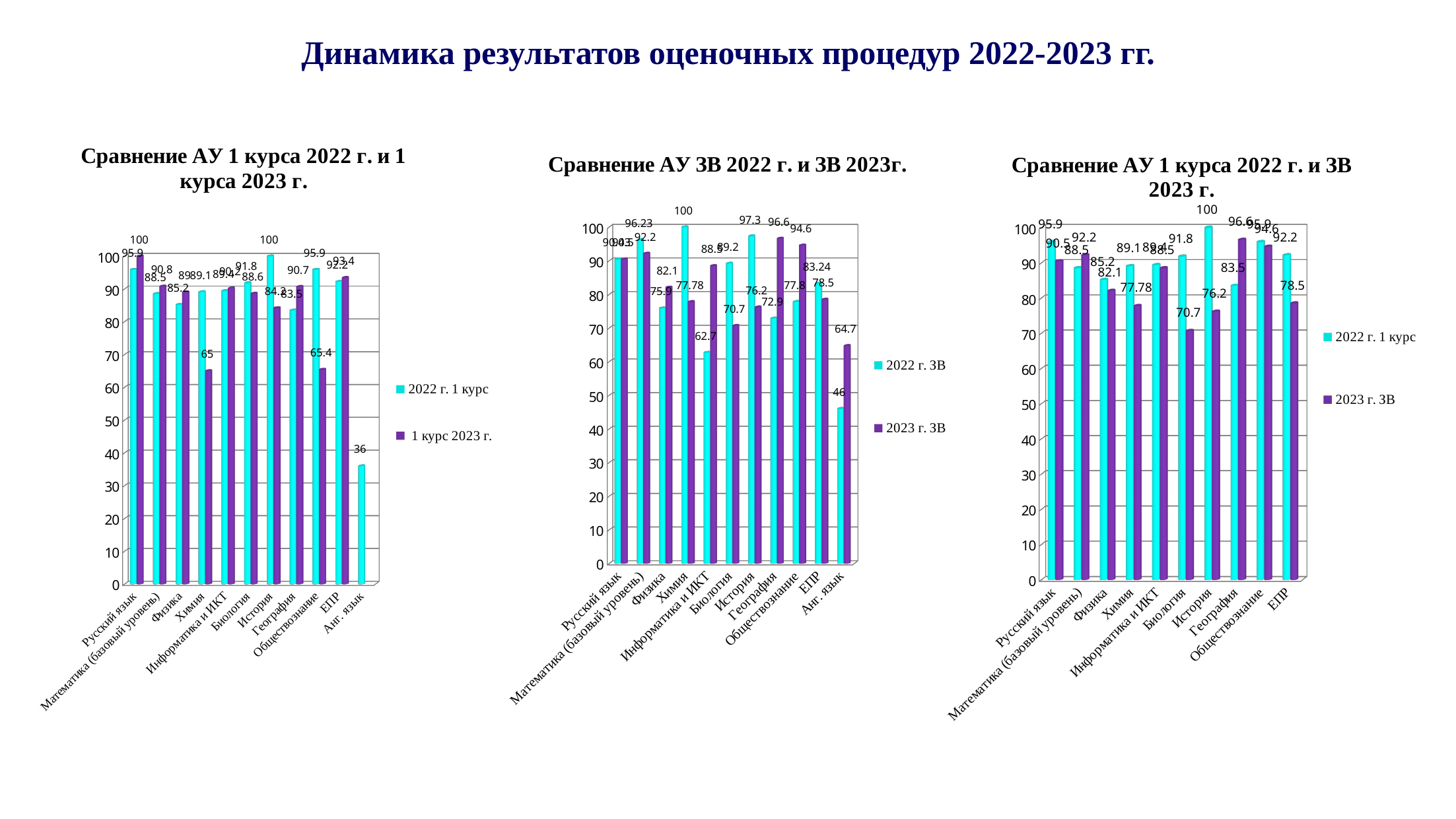
In the right chart 'Сравнение АУ 1 курса 2022 г. и ЗВ 2023 г.', which is larger for Биология: the 2022 г. 1 курс value or the 2023 г. ЗВ value? 2022 г. 1 курс In the middle chart 'Сравнение АУ ЗВ 2022 г. и ЗВ 2023г.', is the 2022 г. ЗВ value for География greater or less than 80? less In the left chart 'Сравнение АУ 1 курса 2022 г. и 1 курса 2023 г.', what is the value for Химия in the 1 курс 2023 г. series? 65 In the left chart 'Сравнение АУ 1 курса 2022 г. и 1 курса 2023 г.', how many series does the legend list? 2 In the middle chart 'Сравнение АУ ЗВ 2022 г. и ЗВ 2023г.', what is the value for Информатика и ИКТ in the 2022 г. ЗВ series? 62.7 In the middle chart 'Сравнение АУ ЗВ 2022 г. и ЗВ 2023г.', what is the difference between the 2022 г. ЗВ and 2023 г. ЗВ values for Анг. язык? 18.7 In the left chart 'Сравнение АУ 1 курса 2022 г. и 1 курса 2023 г.', which category has the lowest value in the 2022 г. 1 курс series? Анг. язык In the left chart 'Сравнение АУ 1 курса 2022 г. и 1 курса 2023 г.', what is the value for Анг. язык in the 2022 г. 1 курс series? 36 In the middle chart 'Сравнение АУ ЗВ 2022 г. и ЗВ 2023г.', which category has the highest value in the 2022 г. ЗВ series? Химия In the right chart 'Сравнение АУ 1 курса 2022 г. и ЗВ 2023 г.', how many categories are shown on the x axis? 10 In the middle chart 'Сравнение АУ ЗВ 2022 г. и ЗВ 2023г.', what is the value for Анг. язык in the 2023 г. ЗВ series? 64.7 What type of chart is the right chart 'Сравнение АУ 1 курса 2022 г. и ЗВ 2023 г.'? Bar chart